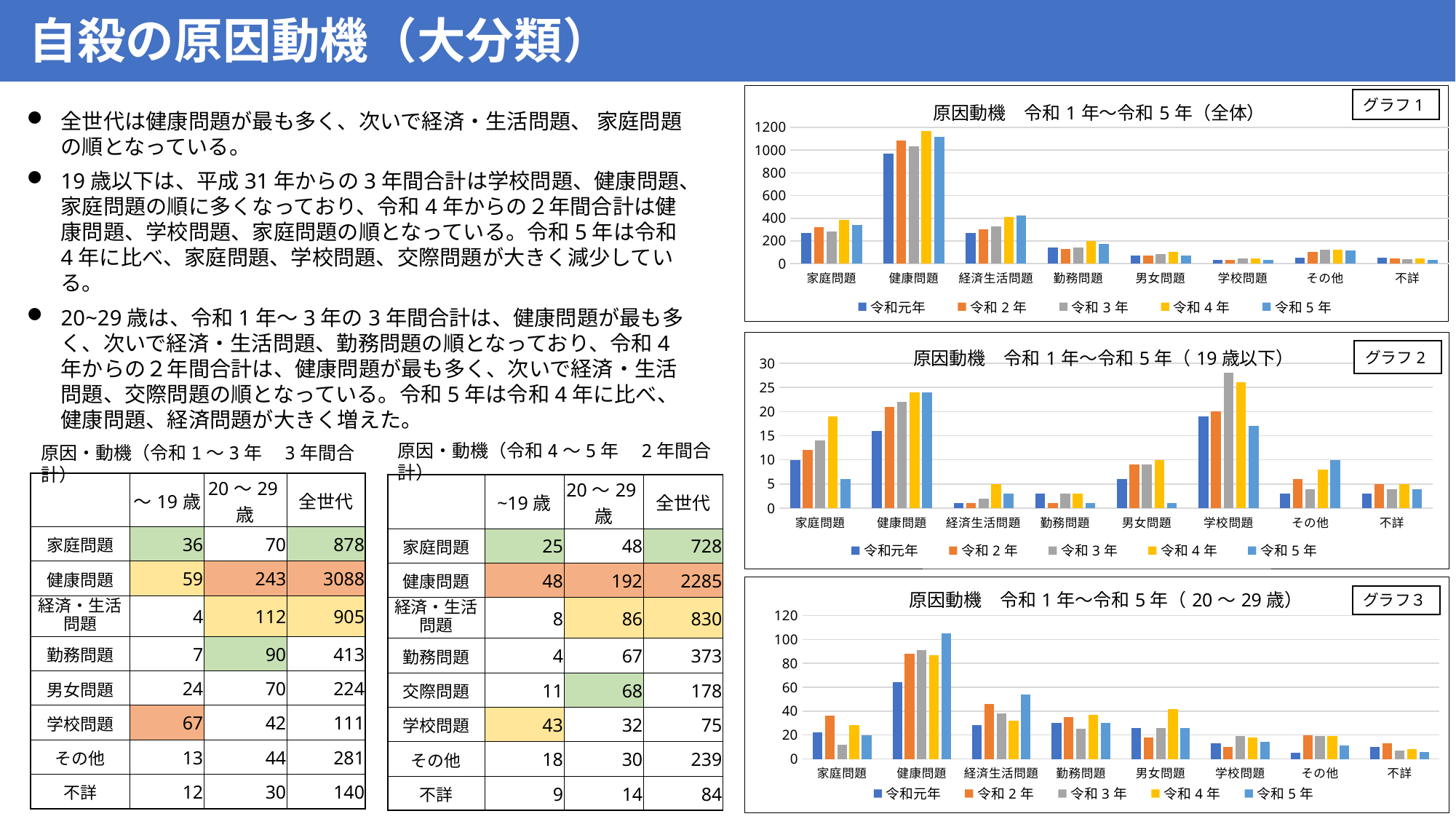
In the chart titled 原因動機 令和1年～令和5年（20～29歳）(グラフ3), is the value for 健康問題 in 令和5年 greater or less than 100? greater What kind of chart is the chart titled 原因動機 令和1年～令和5年（20～29歳）(グラフ3)? bar chart In the chart titled 原因動機 令和1年～令和5年（全体）(グラフ1), is the value for 勤務問題 in 令和4年 greater or less than 400? less How many categories are shown on the x axis of the chart titled 原因動機 令和1年～令和5年（全体）(グラフ1)? 8 In the chart titled 原因動機 令和1年～令和5年（全体）(グラフ1), is the value for 健康問題 in 令和4年 greater or less than 1000? greater In the chart titled 原因動機 令和1年～令和5年（20～29歳）(グラフ3), which is larger for 健康問題: 令和元年 or 令和5年? 令和5年 In the chart titled 原因動機 令和1年～令和5年（全体）(グラフ1), which category has the highest values? 健康問題 In the chart titled 原因動機 令和1年～令和5年（19歳以下）(グラフ2), which category has the highest bar? 学校問題 How many series does the legend list in the chart titled 原因動機 令和1年～令和5年（全体）(グラフ1)? 5 In the chart titled 原因動機 令和1年～令和5年（19歳以下）(グラフ2), which is larger for 学校問題: 令和3年 or 令和5年? 令和3年